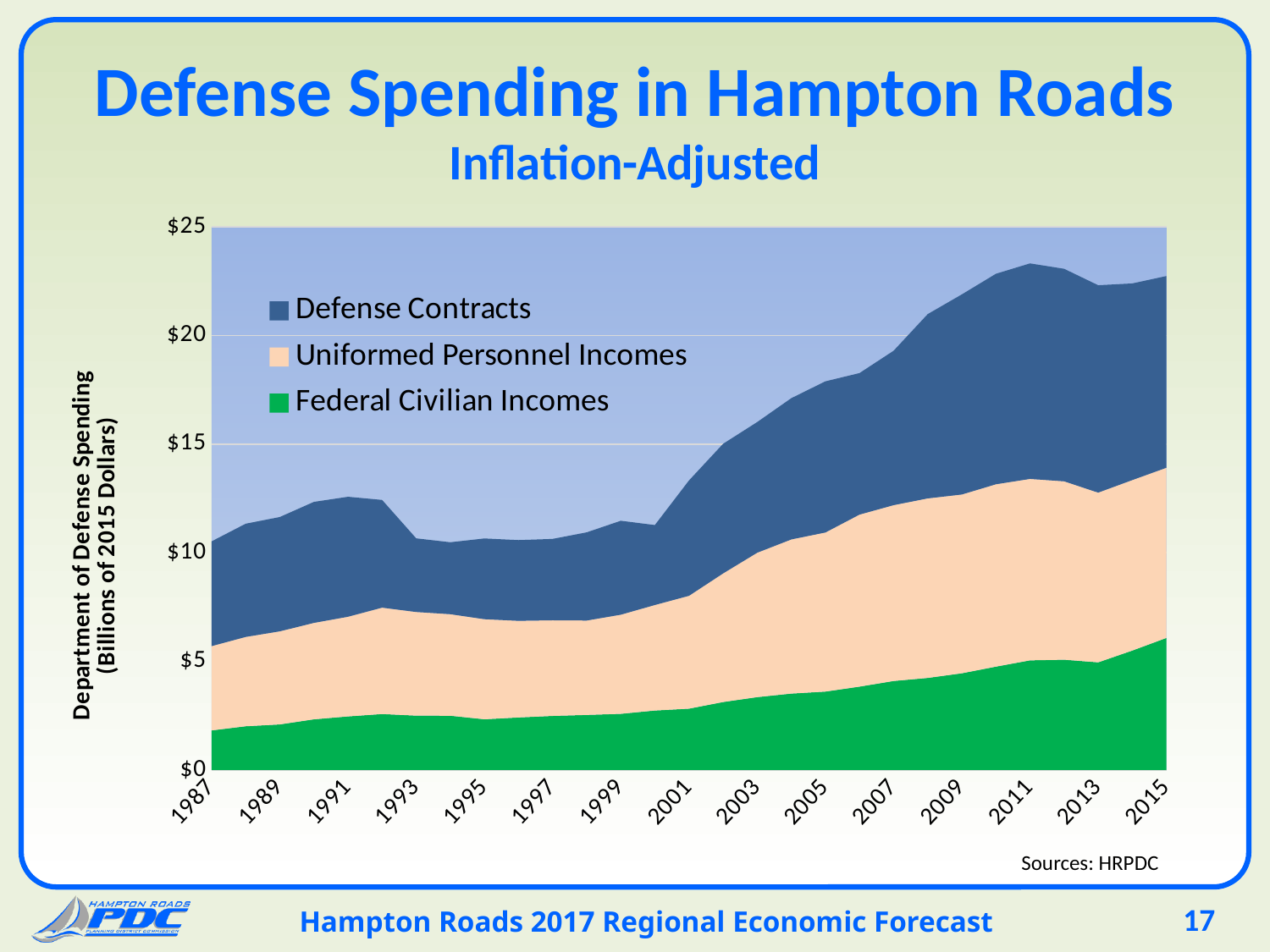
Is the total defense spending in 2015 greater or less than $20? greater How many series does the legend list? 3 Does total defense spending generally rise or fall from 1987 to 2015? rise What are the three series listed in the legend? Defense Contracts, Uniformed Personnel Incomes, Federal Civilian Incomes What is the y-axis title of the chart? Department of Defense Spending (Billions of 2015 Dollars) Is the total defense spending in 1987 greater or less than $15? less Is the value for Federal Civilian Incomes in 1987 greater or less than $5? less How many year labels are shown on the x axis? 15 Which series is the smallest in 1987? Federal Civilian Incomes What kind of chart is shown on the slide? Stacked area chart